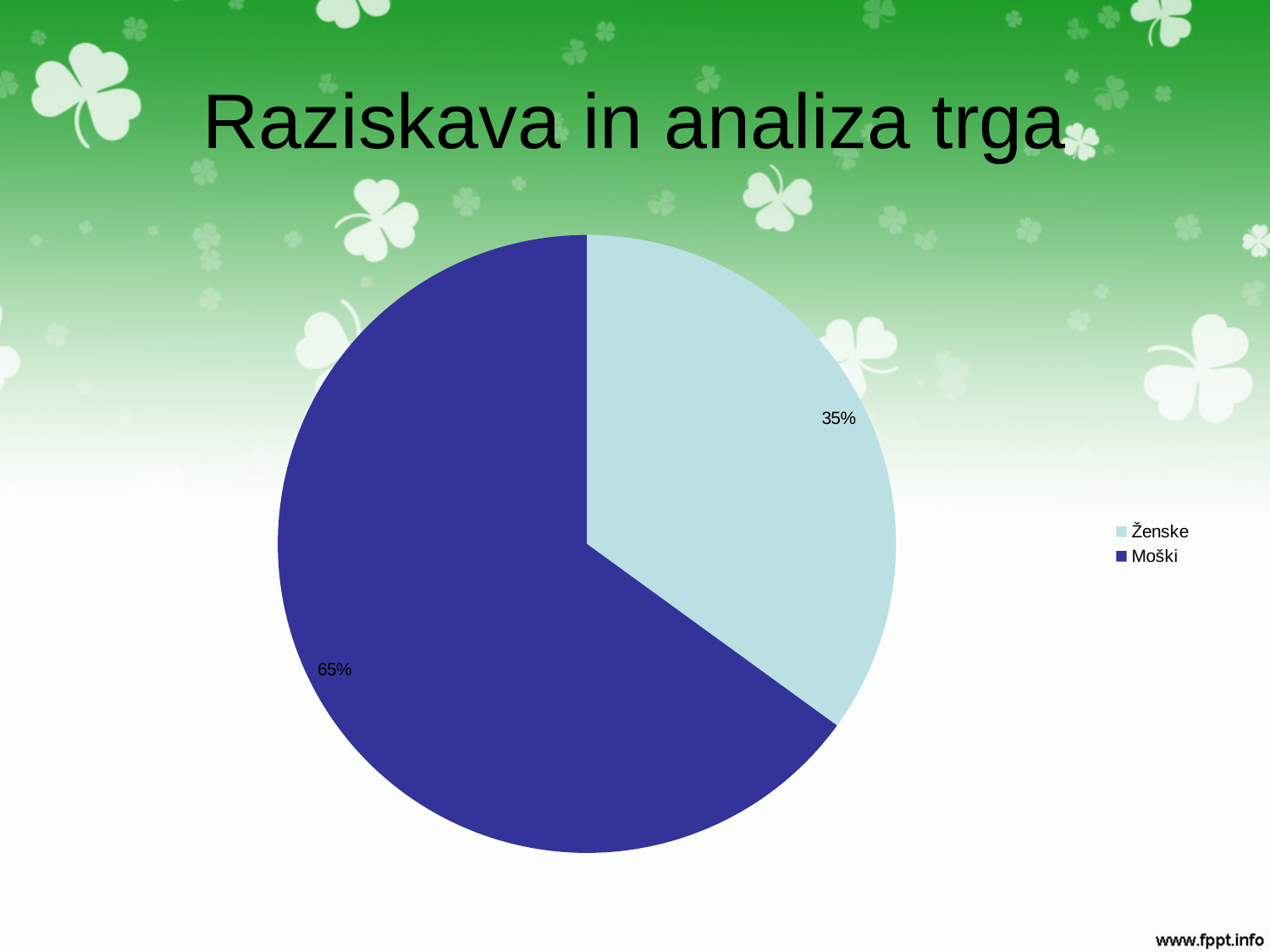
Which category has the smallest slice of the pie? Ženske What share of the pie does Moški represent? 65% What kind of chart is shown on the slide? pie chart What is the difference in percentage points between the Moški and Ženske slices? 30% How many entries does the legend list? 2 How many slices does the pie chart have? 2 Which slice is larger, Ženske or Moški? Moški What is the title of the slide containing the chart? Raziskava in analiza trga Which category has the largest slice of the pie? Moški Which category is shown in dark blue in the pie chart? Moški What share of the pie does Ženske represent? 35%